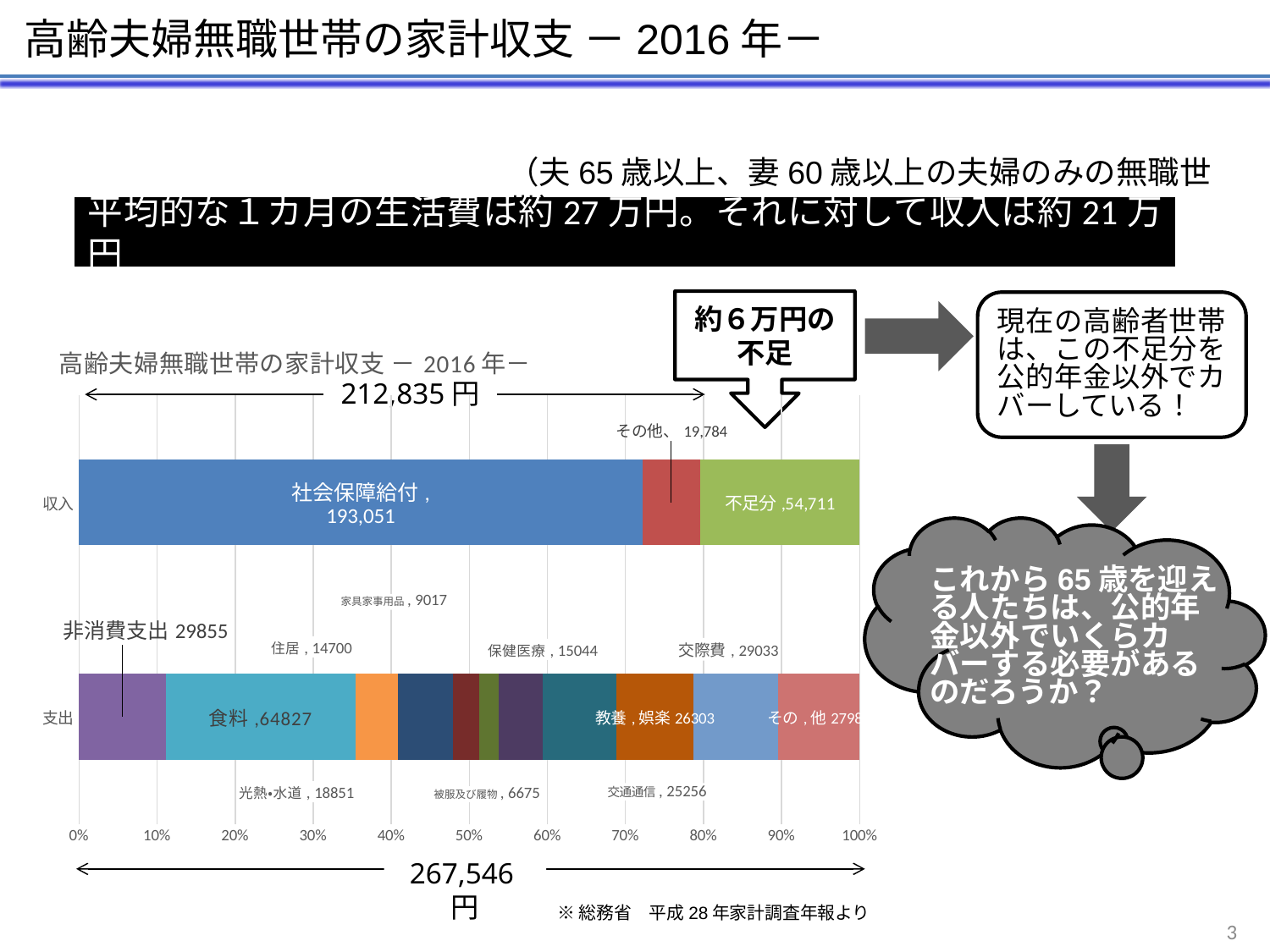
Which is larger in the 支出 bar, 食料 or 交通通信? 食料 What is the value of 不足分 in the 収入 bar? 54,711 What is the value of 社会保障給付 in the 収入 bar? 193,051 What kind of chart is shown on the slide? Stacked bar chart Which segment of the 収入 bar is the smallest? その他 What is the value of 交際費 in the 支出 bar? 29033 What total amount is shown for the 支出 bar below the chart? 267,546円 What is the value of 非消費支出 in the 支出 bar? 29855 Which segment of the 収入 bar is the largest? 社会保障給付 What is the value of 食料 in the 支出 bar? 64827 What is the difference between 社会保障給付 and 不足分 in the 収入 bar? 138,340 How many bars (categories) does the chart show? 2